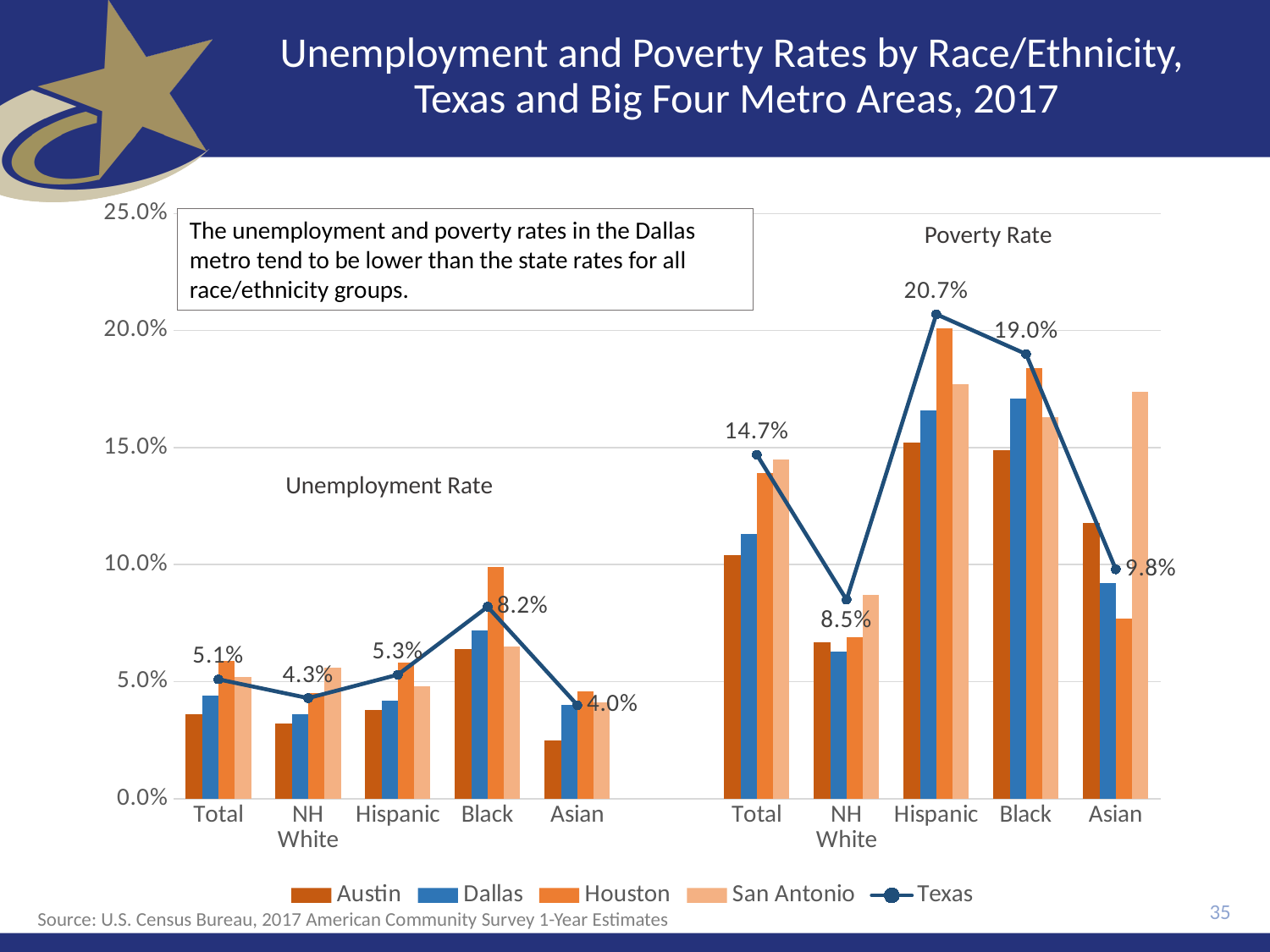
Is the Austin unemployment rate for Asian residents greater or less than 5.0%? less What is the Texas poverty rate for Hispanic residents? 20.7% What is the Texas poverty rate for the Total category? 14.7% How many percentage points higher is the Texas poverty rate for Hispanic residents than for Black residents? 1.7 percentage points Among the Texas unemployment rate values, which race/ethnicity group has the lowest rate? Asian Which is larger, the Texas unemployment rate for Black residents or for Hispanic residents? Black How many series does the legend list? 5 What is the Texas unemployment rate for Black residents? 8.2% Is the San Antonio poverty rate for Asian residents greater or less than 15.0%? greater What kind of chart is shown on the slide? A bar chart with a line series Among the Texas poverty rate values, which race/ethnicity group has the highest rate? Hispanic Does the Texas poverty rate rise or fall from the Total category to the NH White category? fall